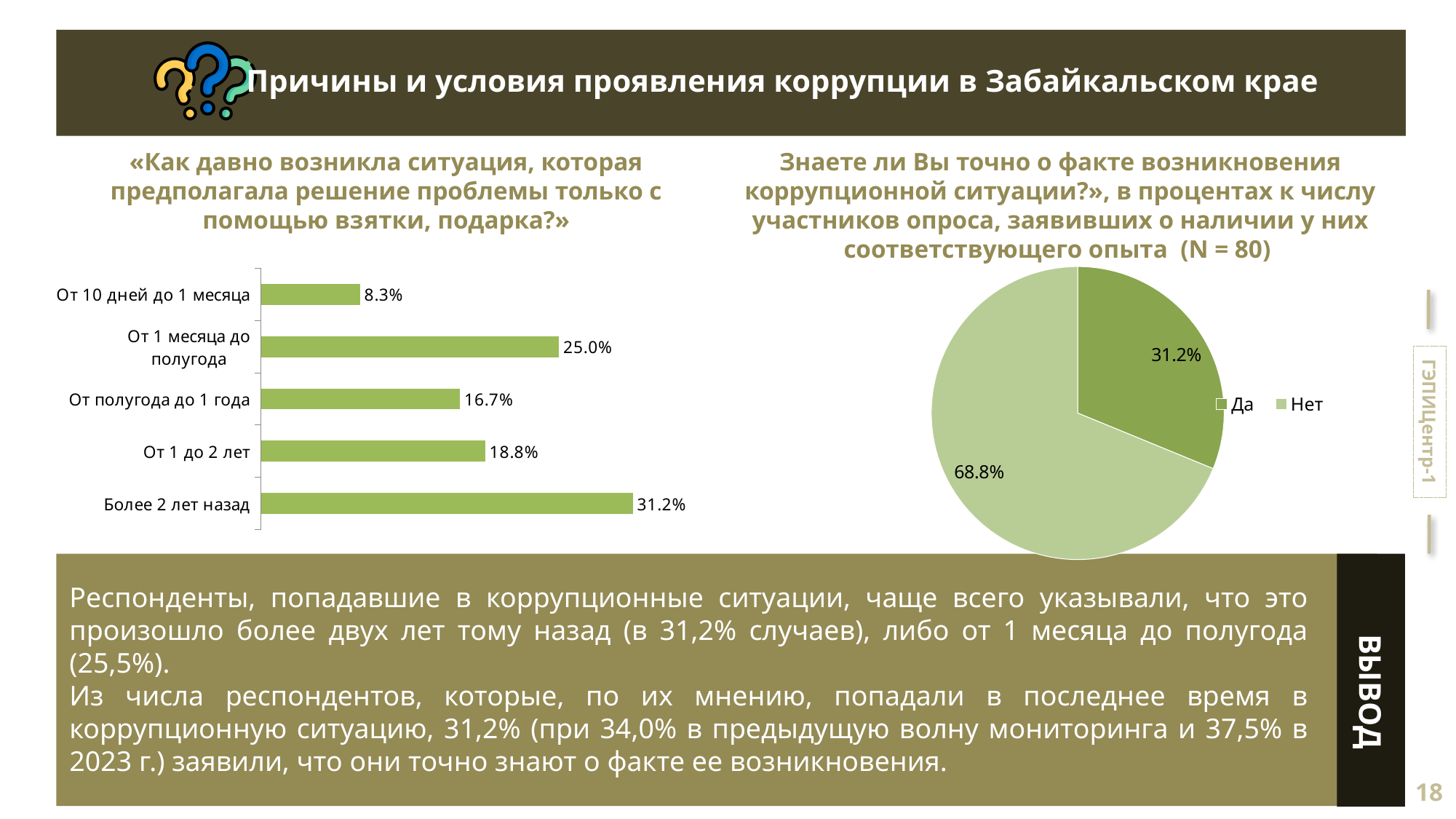
What kind of chart is the chart on the left of the slide? Bar chart In the left bar chart, which is larger: «От 1 до 2 лет» or «От полугода до 1 года»? От 1 до 2 лет In the left bar chart, which category has the highest value? Более 2 лет назад In the pie chart on the right, what share is labelled «Нет»? 68.8% How many categories are shown in the left bar chart? 5 In the left bar chart, what is the value for «От 10 дней до 1 месяца»? 8.3% In the left bar chart, which category has the lowest value? От 10 дней до 1 месяца What kind of chart is the chart on the right of the slide? Pie chart In the left bar chart, what is the difference between «От 1 месяца до полугода» and «От полугода до 1 года»? 8.3% In the left bar chart, what is the value for «Более 2 лет назад»? 31.2% In the pie chart on the right, what share is labelled «Да»? 31.2% How many entries does the legend of the pie chart on the right list? 2